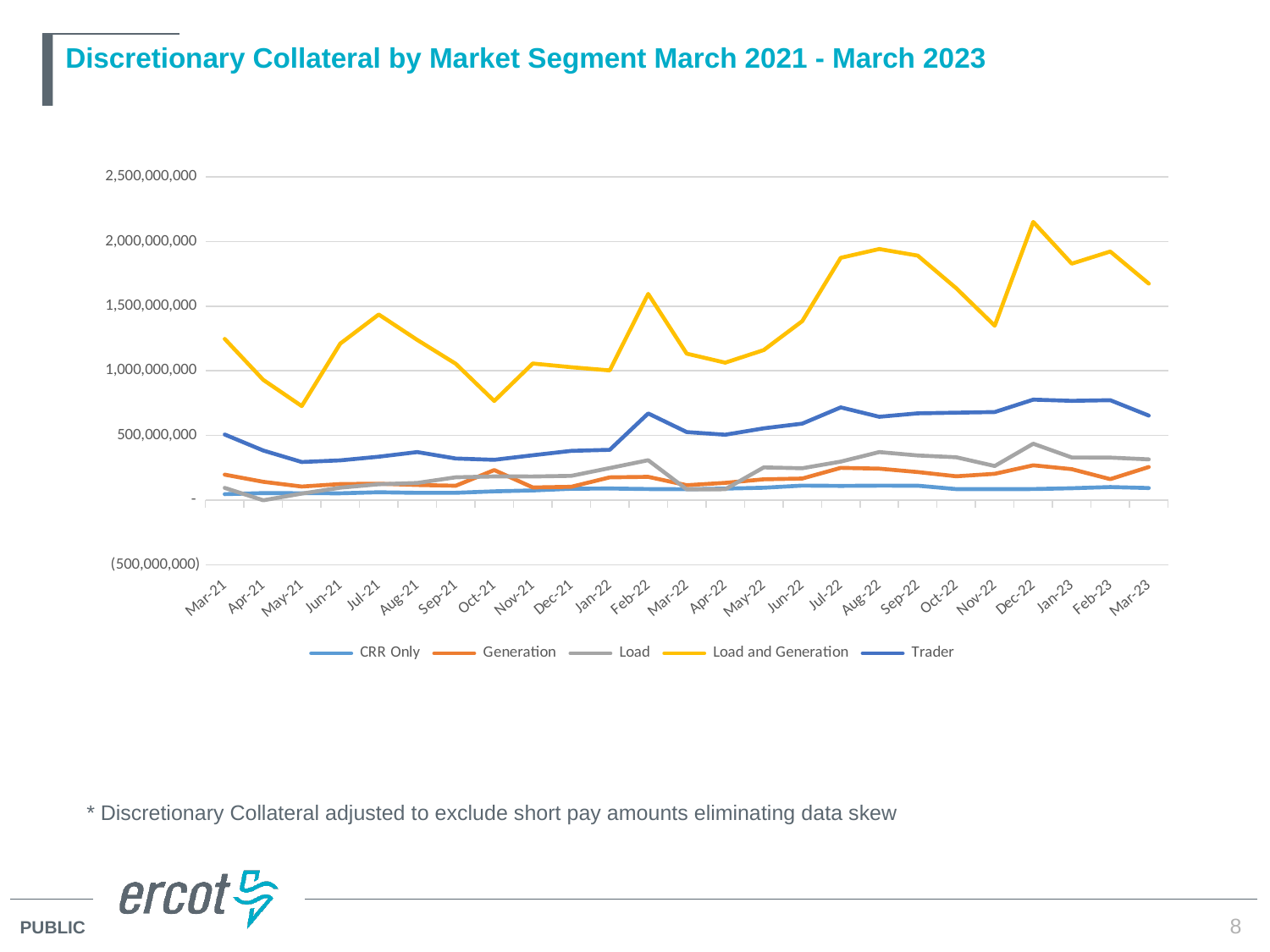
Does the Load and Generation series rise or fall from Sep-22 to Nov-22? Fall Is the value for Load and Generation in Jul-22 greater or less than 1,500,000,000? greater Which is larger in Mar-23, the Trader value or the Generation value? Trader In which month does the Load and Generation series reach its highest value? Dec-22 What kind of chart is shown on the slide? Line chart How many series does the legend list? 5 Which series has the highest value in Dec-22? Load and Generation What is the title of the chart? Discretionary Collateral by Market Segment March 2021 - March 2023 How many months are plotted along the x axis? 25 Is the value for Load and Generation in Dec-22 greater or less than 2,000,000,000? greater Is the value for Load and Generation in May-21 greater or less than 1,000,000,000? less